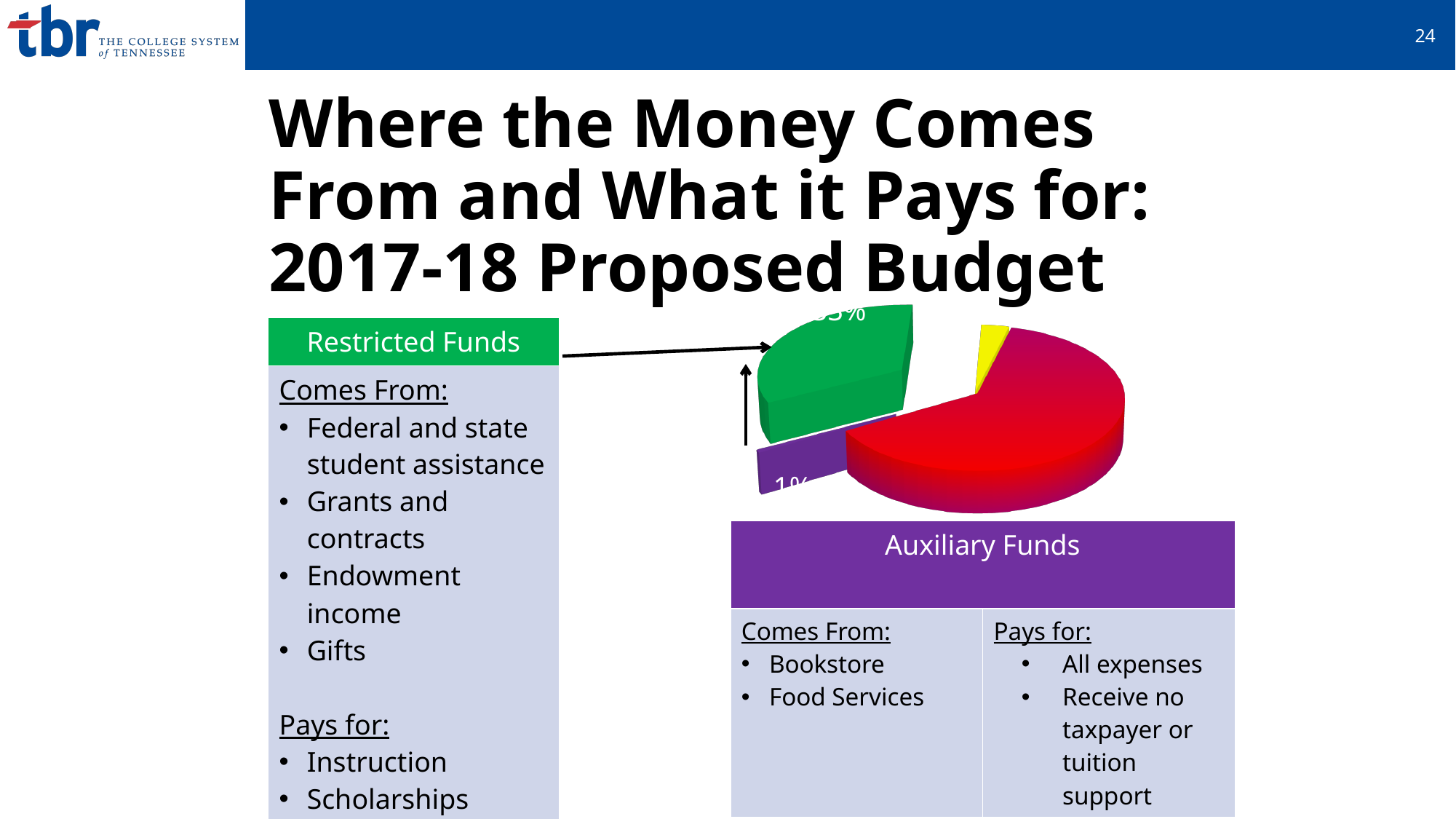
By how many percentage points does the Restricted Funds slice exceed the Auxiliary Funds slice? 32 Which is larger in the pie chart, the Restricted Funds slice or the Auxiliary Funds slice? Restricted Funds Which colour slice is the largest in the pie chart? red How many slices does the pie chart have? 4 What percentage does the pie chart show for Auxiliary Funds (the purple slice)? 1% What colour is the slice that the Restricted Funds box points to? green What colour is the slice linked to the Auxiliary Funds box? purple What percentage does the pie chart show for Restricted Funds (the green slice)? 33% What kind of chart is shown on the slide? pie chart